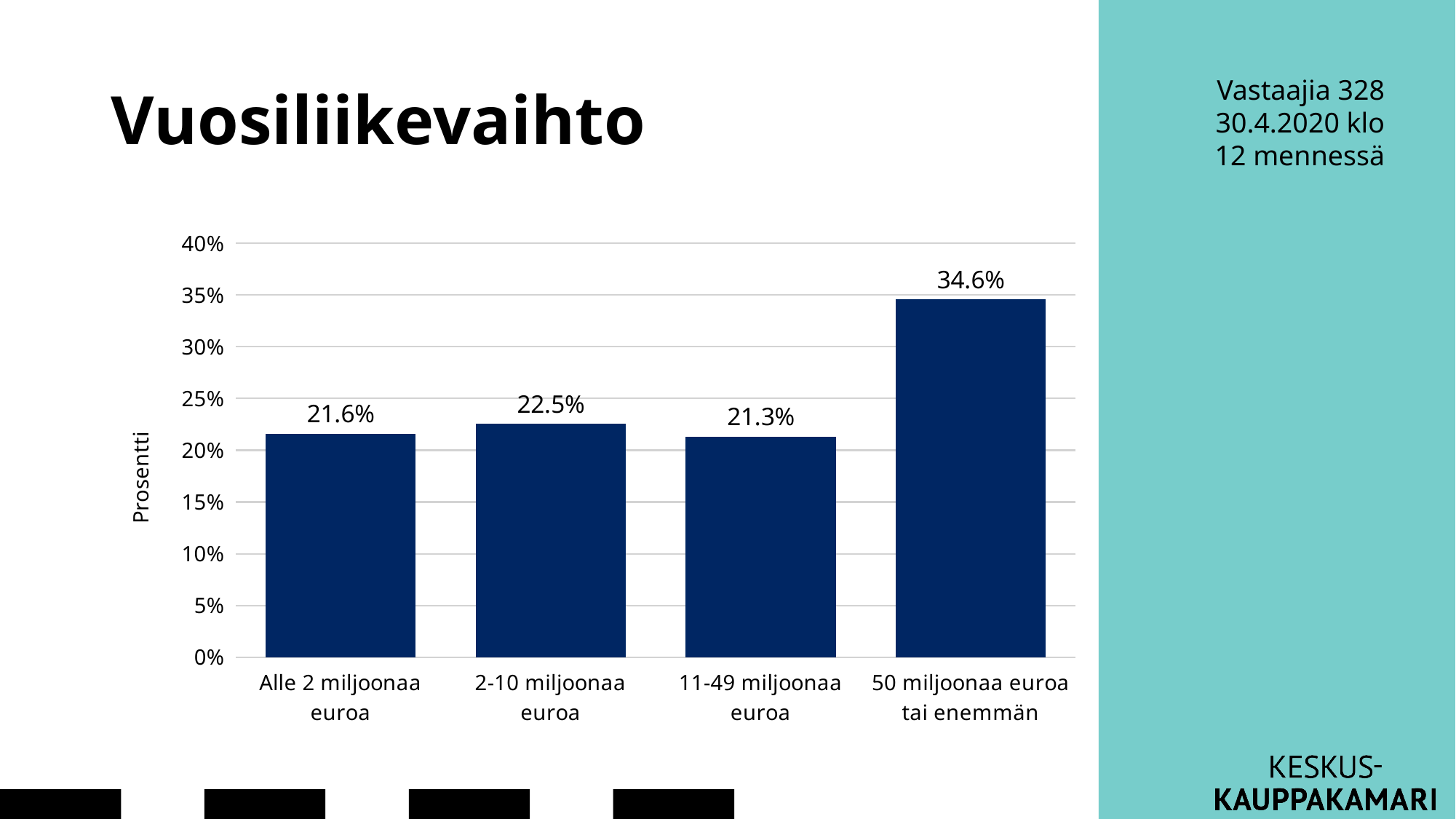
What is the value for "50 miljoonaa euroa tai enemmän"? 34.6% What is the difference between the values for "50 miljoonaa euroa tai enemmän" and "2-10 miljoonaa euroa"? 12.1% What is the difference between the values for "2-10 miljoonaa euroa" and "11-49 miljoonaa euroa"? 1.2% What is the value for "Alle 2 miljoonaa euroa"? 21.6% Is the value for "50 miljoonaa euroa tai enemmän" greater or less than 30%? greater Which category has the highest value? 50 miljoonaa euroa tai enemmän How many categories are shown on the x axis? 4 What is the value for "11-49 miljoonaa euroa"? 21.3% What kind of chart is shown on the slide? bar chart What is the title of the chart on the slide? Vuosiliikevaihto Which is larger, the value for "50 miljoonaa euroa tai enemmän" or the value for "Alle 2 miljoonaa euroa"? 50 miljoonaa euroa tai enemmän What is the value for "2-10 miljoonaa euroa"? 22.5%